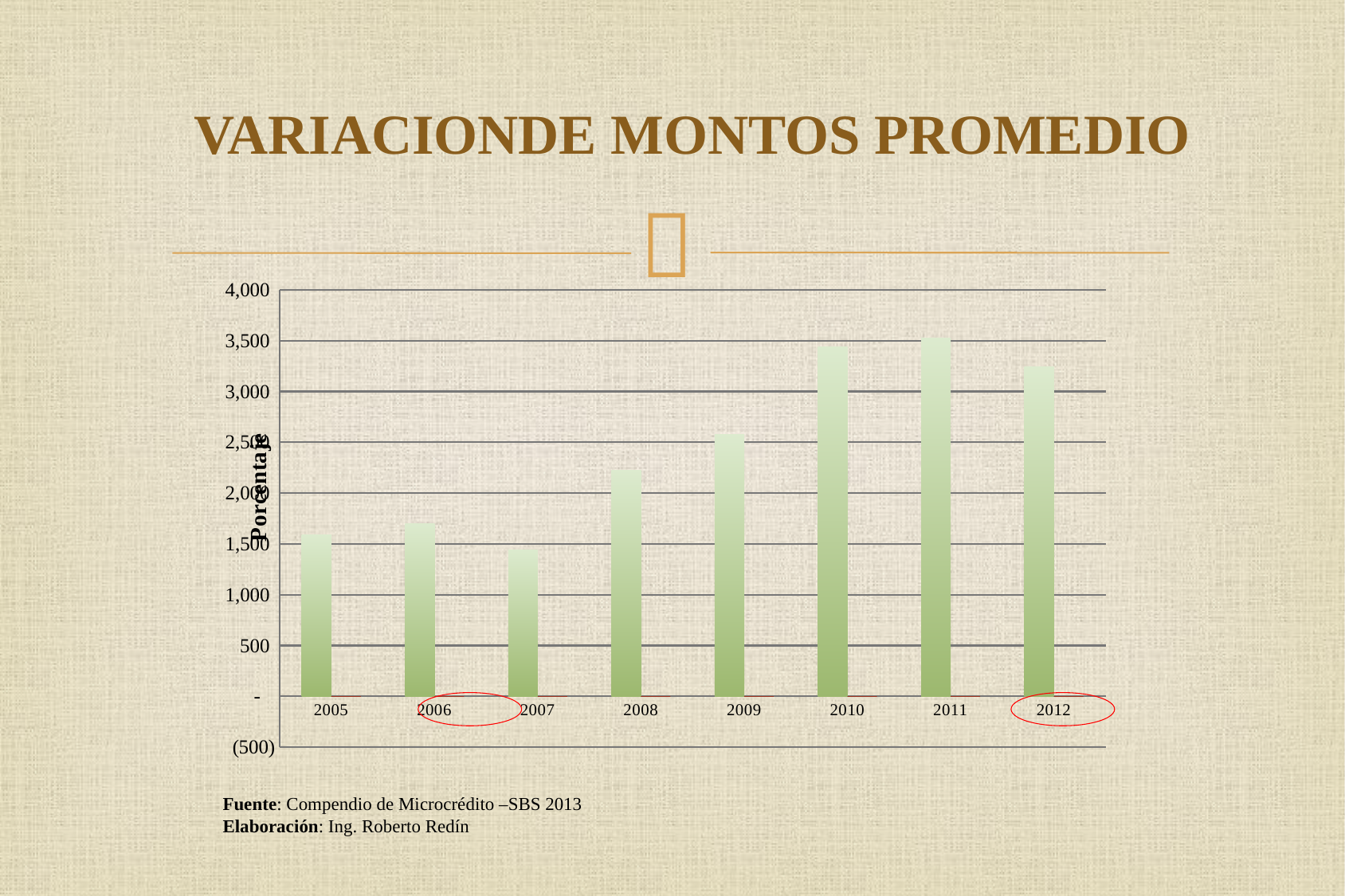
Is the value for 2006 greater or less than 2,000? less What is the label on the vertical axis of the chart? Porcentaje How many years are shown on the x axis of the chart? 8 Which is larger, the value for 2008 or the value for 2005? 2008 Which year has the lowest bar in the chart? 2007 Do the values rise or fall from 2007 to 2011? rise Is the value for 2008 greater or less than 2,000? greater What kind of chart is shown on the slide? bar chart Is the value for 2007 greater or less than 1,500? less Which year has the highest bar in the chart? 2011 Which is larger, the value for 2012 or the value for 2009? 2012